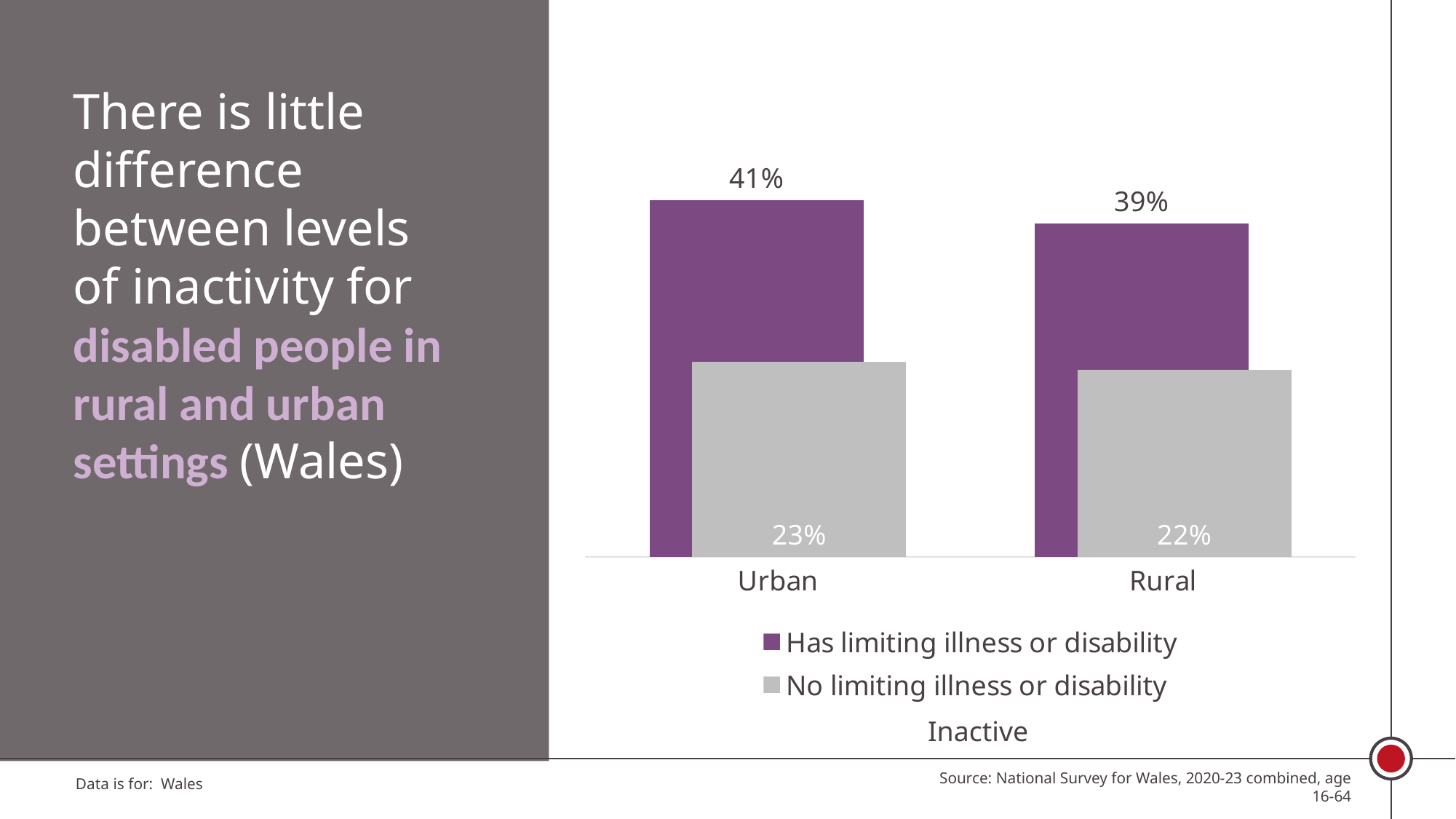
How many categories are shown on the x axis? 2 Which category has the highest value in the 'Has limiting illness or disability' series? Urban For Rural, which is larger: the 'Has limiting illness or disability' value or the 'No limiting illness or disability' value? Has limiting illness or disability What is the difference between the 'Has limiting illness or disability' and 'No limiting illness or disability' values for Urban? 18 percentage points What is the value for Urban in the 'Has limiting illness or disability' series? 41% What is the value for Rural in the 'No limiting illness or disability' series? 22% What is the value for Rural in the 'Has limiting illness or disability' series? 39% Which category has the lowest value in the 'No limiting illness or disability' series? Rural What is the value for Urban in the 'No limiting illness or disability' series? 23% What kind of chart is shown on the slide? Bar chart How many series does the legend list? 2 What is the difference between the Urban and Rural values in the 'Has limiting illness or disability' series? 2 percentage points